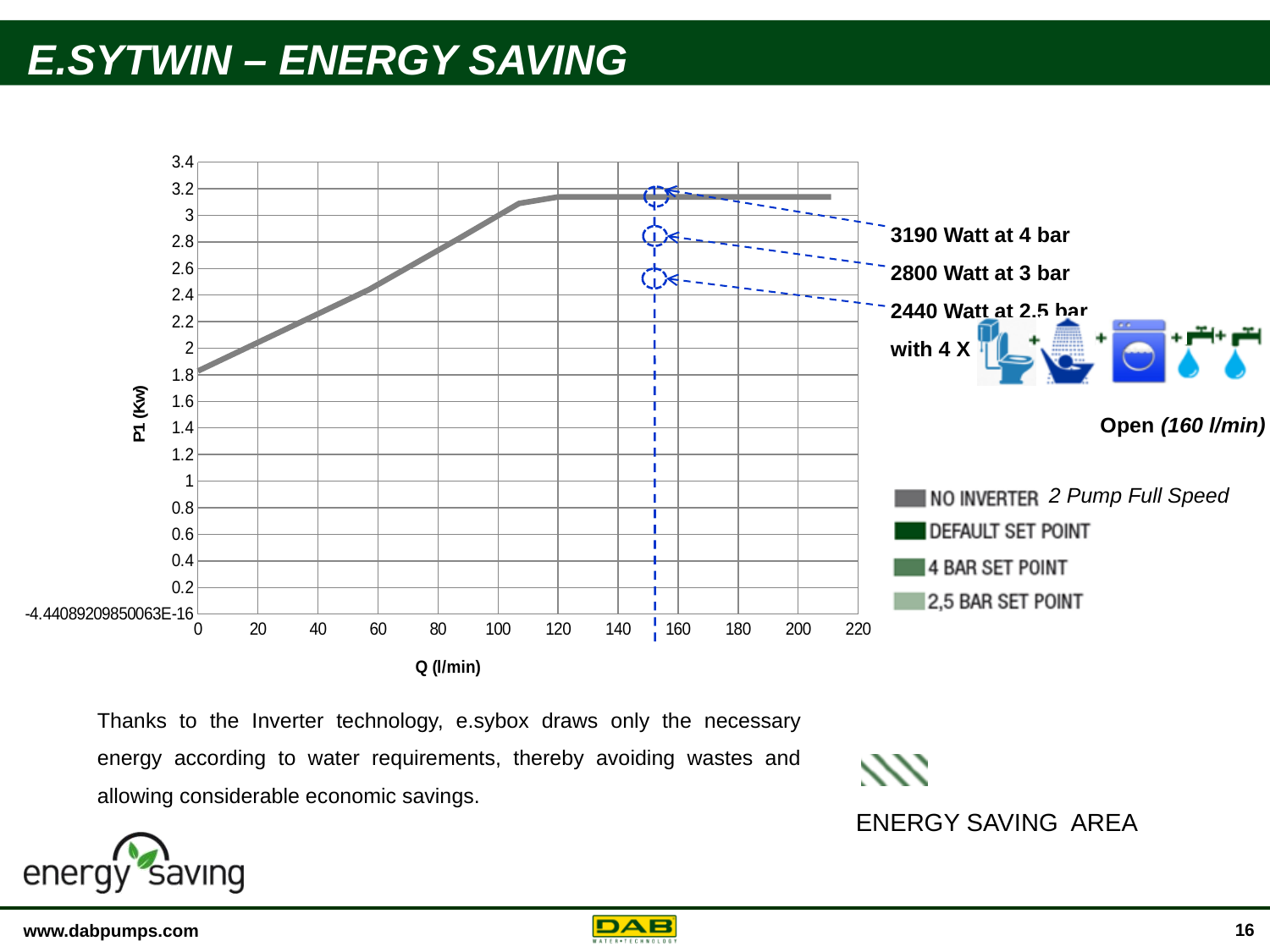
What is the label of the x axis of the chart? Q (l/min) Does the NO INVERTER line rise or fall as Q increases from 0 to 100 l/min? rise Which annotated pressure has the lowest Watt value on the chart? 2.5 bar According to the annotations on the chart, what is the difference in Watt between the value at 4 bar and the value at 2.5 bar? 750 Watt Is the value of the NO INVERTER line at Q = 80 l/min greater or less than 3? less Is the value of the NO INVERTER line at Q = 160 l/min greater or less than 3? greater Is the value of the NO INVERTER line at Q = 0 l/min greater or less than 2? less According to the annotation on the chart, how many Watt are drawn at 3 bar? 2800 Watt What is the label of the y axis of the chart? P1 (Kw) How many entries does the chart legend list? 4 What kind of chart is shown on the slide? line chart